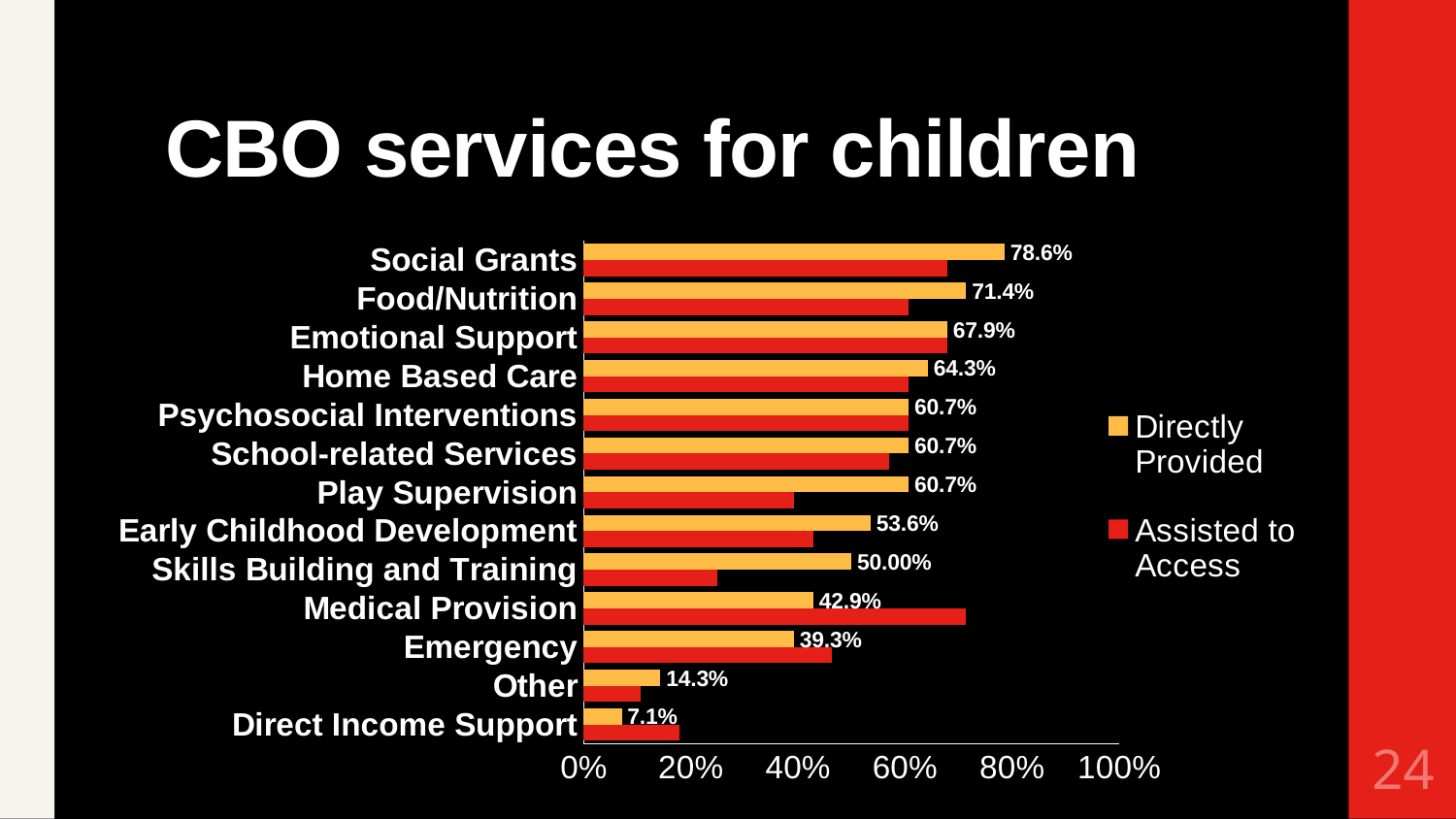
Is the Assisted to Access value for Skills Building and Training greater or less than 40%? less Which service has the lowest Directly Provided value? Direct Income Support How many series does the legend list? 2 Which service has the highest Directly Provided value? Social Grants Is the Assisted to Access value for Medical Provision greater or less than 60%? greater What is the difference between the Directly Provided values for Social Grants and Food/Nutrition? 7.2% What is the Directly Provided value for Direct Income Support? 7.1% How many service categories are shown on the chart? 13 What kind of chart is shown on the slide? Bar chart What is the Directly Provided value for Social Grants? 78.6% Which has a larger Directly Provided value, Medical Provision or Emergency? Medical Provision What is the Directly Provided value for Skills Building and Training? 50.00%